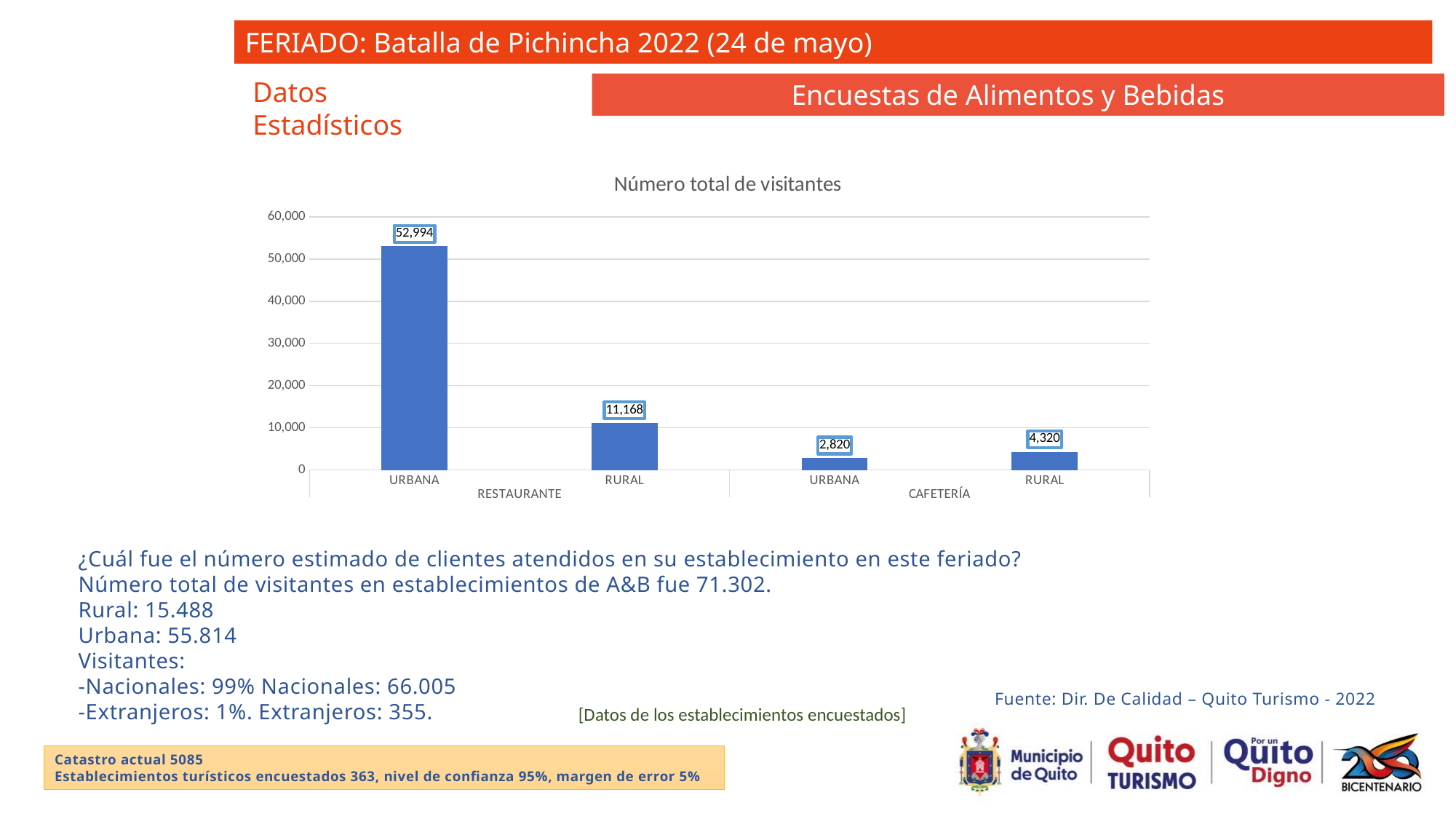
What is the difference between the RURAL and URBANA values under CAFETERÍA in the 'Número total de visitantes' chart? 1,500 Which is larger in the 'Número total de visitantes' chart: RURAL under RESTAURANTE or RURAL under CAFETERÍA? RURAL under RESTAURANTE What is the difference between the URBANA and RURAL values under RESTAURANTE in the 'Número total de visitantes' chart? 41,826 What is the value for RURAL under CAFETERÍA in the 'Número total de visitantes' chart? 4,320 What is the title of the chart on the slide? Número total de visitantes What is the value for URBANA under RESTAURANTE in the 'Número total de visitantes' chart? 52,994 What is the value for URBANA under CAFETERÍA in the 'Número total de visitantes' chart? 2,820 Which bar has the lowest value in the 'Número total de visitantes' chart? URBANA (CAFETERÍA) Is the value for RURAL under RESTAURANTE in the 'Número total de visitantes' chart greater or less than 10,000? greater What kind of chart is the 'Número total de visitantes' chart? bar chart Which bar has the highest value in the 'Número total de visitantes' chart? URBANA (RESTAURANTE) How many bars are plotted in the 'Número total de visitantes' chart? 4